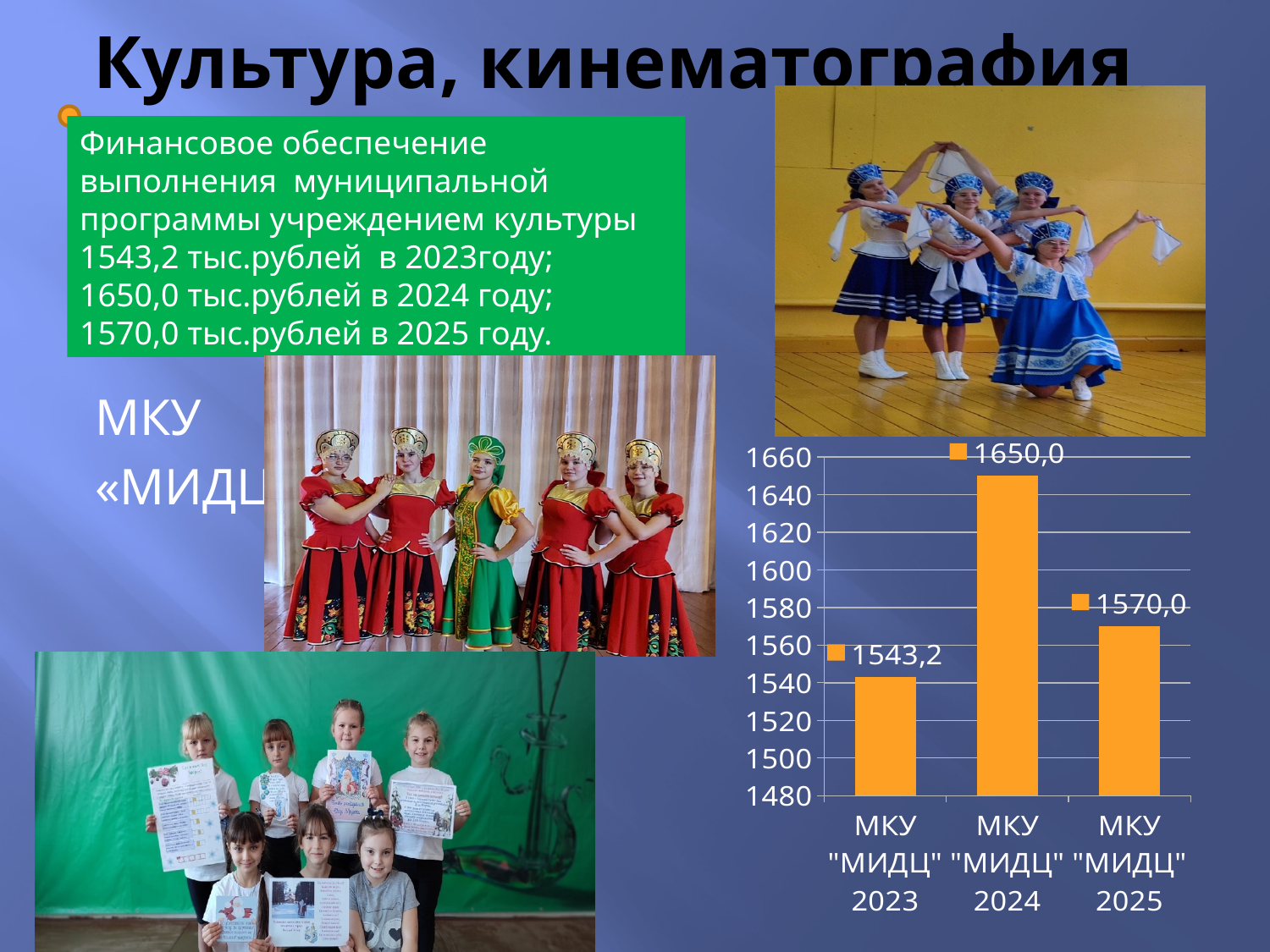
What is the difference between the values for 2024 and 2023? 106,8 What is the value for МКУ "МИДЦ" 2023? 1543,2 What kind of chart is shown on the slide? bar chart Which category has the lowest value? МКУ "МИДЦ" 2023 Is the value for МКУ "МИДЦ" 2025 greater or less than 1600? less Which category has the highest value? МКУ "МИДЦ" 2024 Which is larger, the value for 2025 or the value for 2023? 2025 What is the value for МКУ "МИДЦ" 2024? 1650,0 How many categories are shown in the chart? 3 What is the difference between the values for 2024 and 2025? 80,0 What is the value for МКУ "МИДЦ" 2025? 1570,0 What colour are the bars in the chart? orange